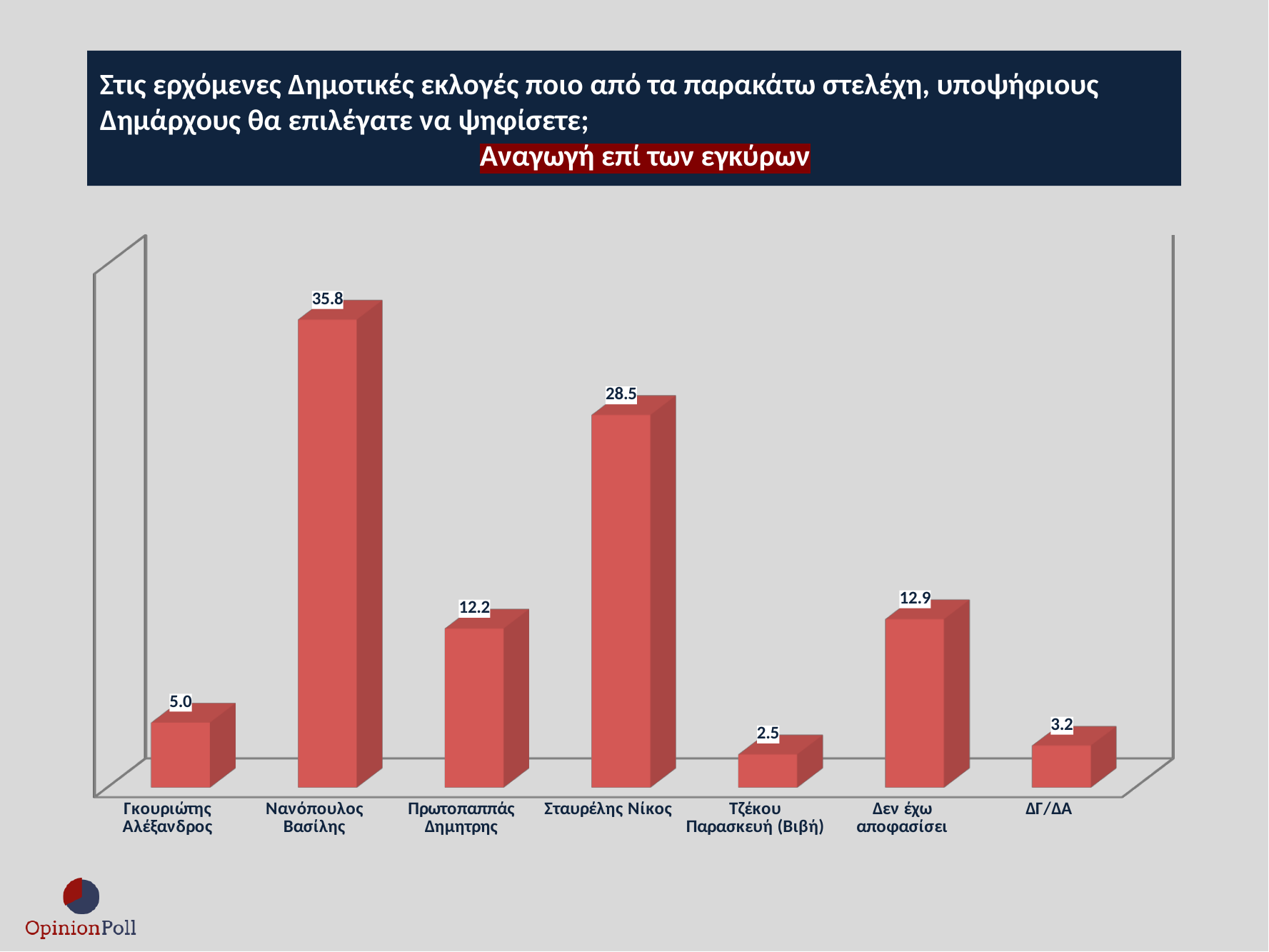
What colour are the bars in the chart? Red Which category has the lowest value? Τζέκου Παρασκευή (Βιβή) What is the difference between the values for Γκουριώτης Αλέξανδρος and Τζέκου Παρασκευή (Βιβή)? 2.5 What is the value for Σταυρέλης Νίκος? 28.5 What is the value for Δεν έχω αποφασίσει? 12.9 What is the difference between the values for Νανόπουλος Βασίλης and Σταυρέλης Νίκος? 7.3 What kind of chart is shown on the slide? Bar chart What is the value for ΔΓ/ΔΑ? 3.2 Which category has the highest value? Νανόπουλος Βασίλης What is the value for Νανόπουλος Βασίλης? 35.8 Which is larger, the value for Πρωτοπαππάς Δημήτρης or the value for Δεν έχω αποφασίσει? Δεν έχω αποφασίσει How many categories are shown on the x axis? 7